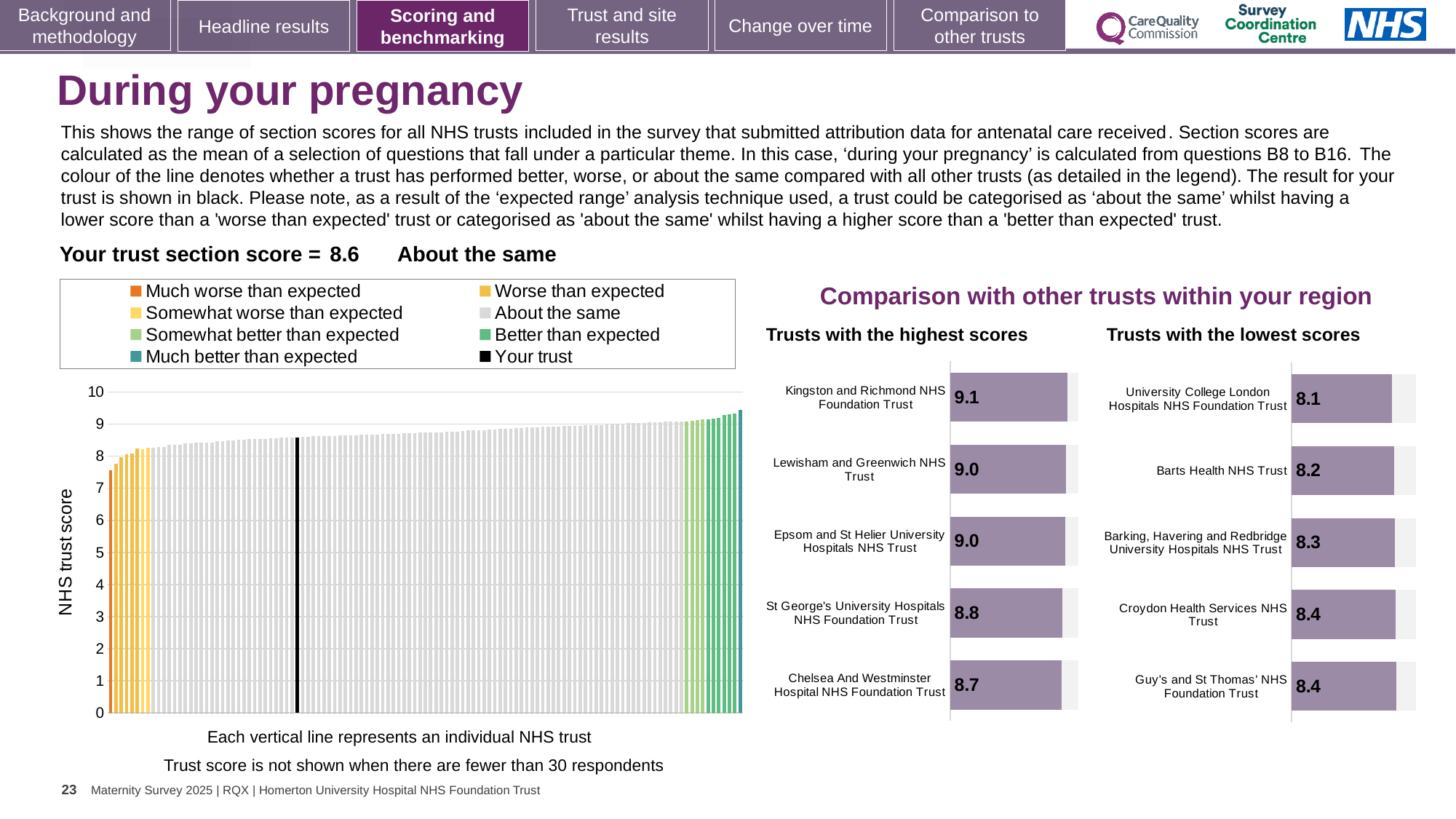
In the 'Trusts with the lowest scores' chart, which trust has the lowest score? University College London Hospitals NHS Foundation Trust What kind of chart is the main chart on the left of the slide? bar chart In the 'Trusts with the highest scores' chart, what is the score for Kingston and Richmond NHS Foundation Trust? 9.1 In the 'Trusts with the highest scores' chart, what is the score for St George's University Hospitals NHS Foundation Trust? 8.8 In the main chart on the left, is the value for the black bar (Your trust) greater or less than 8? greater How many entries does the legend above the main chart on the left list? 8 In the 'Trusts with the lowest scores' chart, which has the larger score: Barts Health NHS Trust or Croydon Health Services NHS Trust? Croydon Health Services NHS Trust In the 'Trusts with the highest scores' chart, which trust has the highest score? Kingston and Richmond NHS Foundation Trust In the 'Trusts with the lowest scores' chart, how many trusts are shown? 5 In the 'Trusts with the lowest scores' chart, what is the score for Barking, Havering and Redbridge University Hospitals NHS Trust? 8.3 In the 'Trusts with the highest scores' chart, what is the difference between the scores of Kingston and Richmond NHS Foundation Trust and Chelsea And Westminster Hospital NHS Foundation Trust? 0.4 In the main chart on the left, do the trust scores rise or fall from left to right? rise